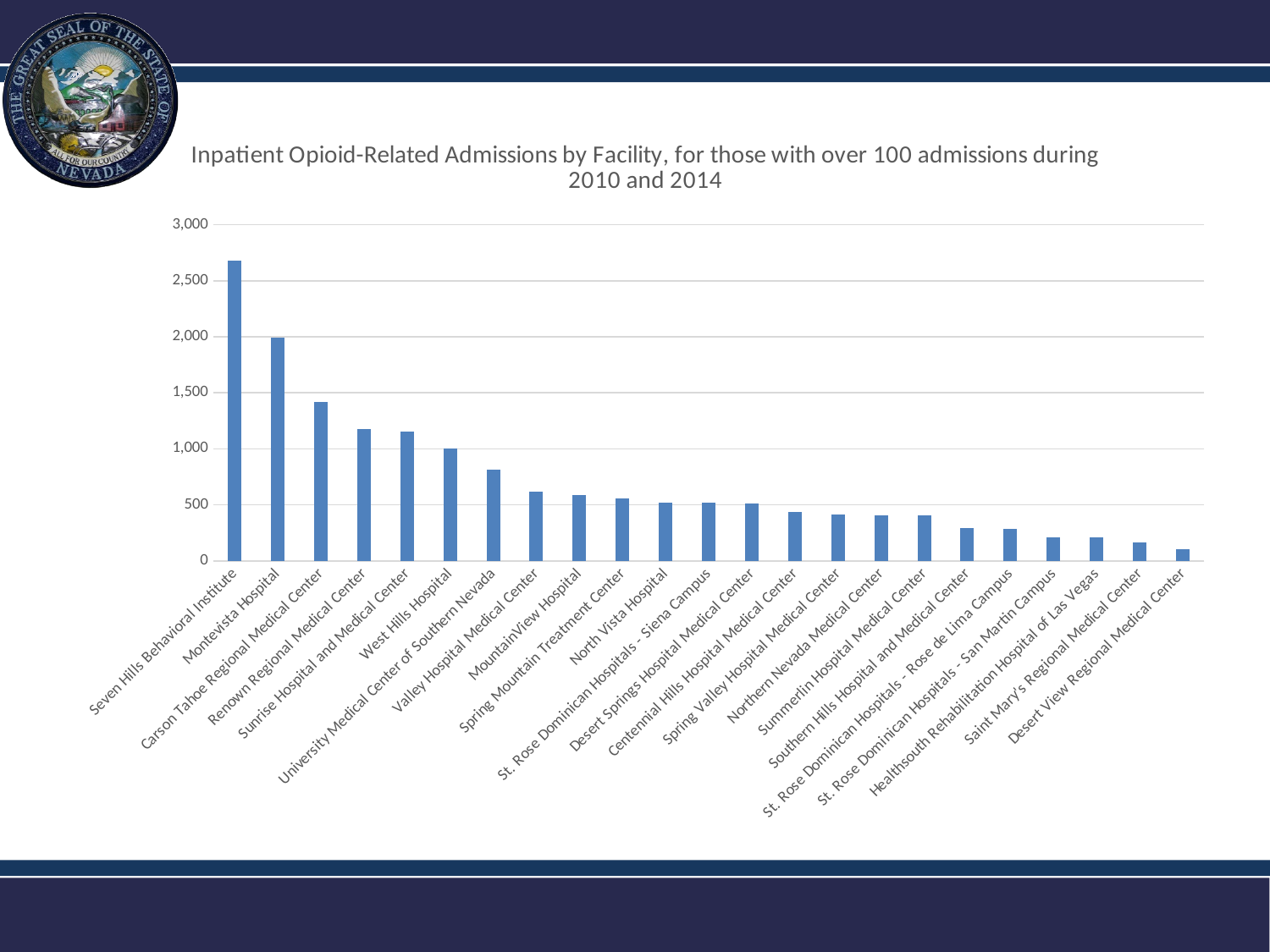
Which facility has the lowest number of inpatient opioid-related admissions? Desert View Regional Medical Center How many facilities are shown in the chart? 23 Is the value for Southern Hills Hospital and Medical Center greater or less than 500? less What kind of chart is shown on the slide? bar chart Is the value for Seven Hills Behavioral Institute greater or less than 2,500? greater Do the values rise or fall moving from left to right along the x axis? fall What is the title of the chart? Inpatient Opioid-Related Admissions by Facility, for those with over 100 admissions during 2010 and 2014 Is the value for Montevista Hospital greater or less than 1,500? greater Which has more admissions, Montevista Hospital or Carson Tahoe Regional Medical Center? Montevista Hospital Which facility has the highest number of inpatient opioid-related admissions? Seven Hills Behavioral Institute